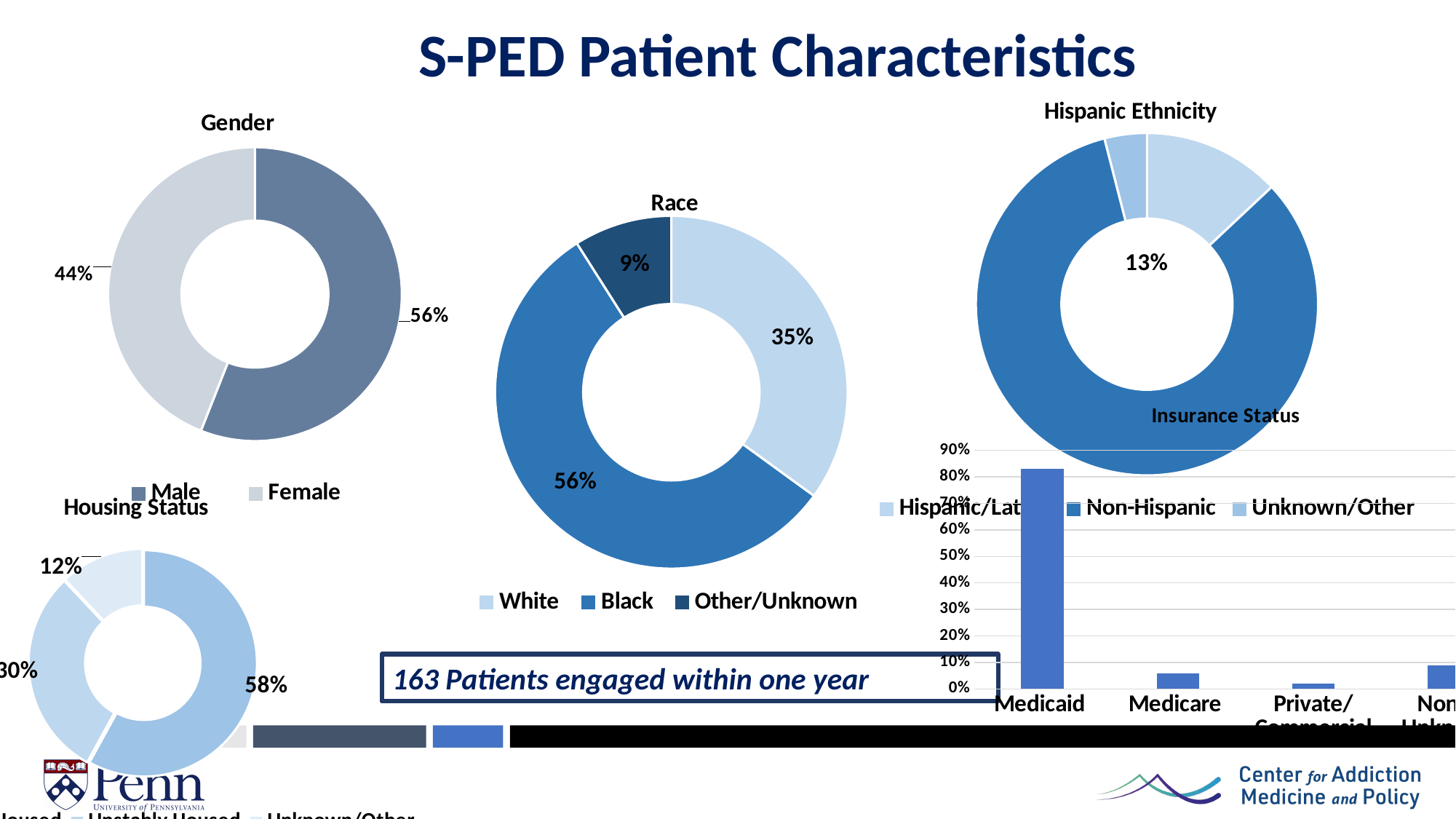
In the Gender chart, what percentage of patients are Female? 44% In the Race chart, what percentage of patients are Black? 56% In the Gender chart, what percentage of patients are Male? 56% How many categories does the Race chart's legend list? 3 In the Insurance Status chart, which category has the highest value? Medicaid In the Insurance Status chart, is the value for Medicaid greater or less than 80%? greater In the Race chart, what is the difference between the Black and White shares? 21% What kind of chart is the Insurance Status chart? bar chart In the Race chart, what percentage of patients are White? 35% In the Hispanic Ethnicity chart, which category has the largest share? Non-Hispanic In the Race chart, which category has the smallest share? Other/Unknown In the Insurance Status chart, is the value for Medicare greater or less than 10%? less